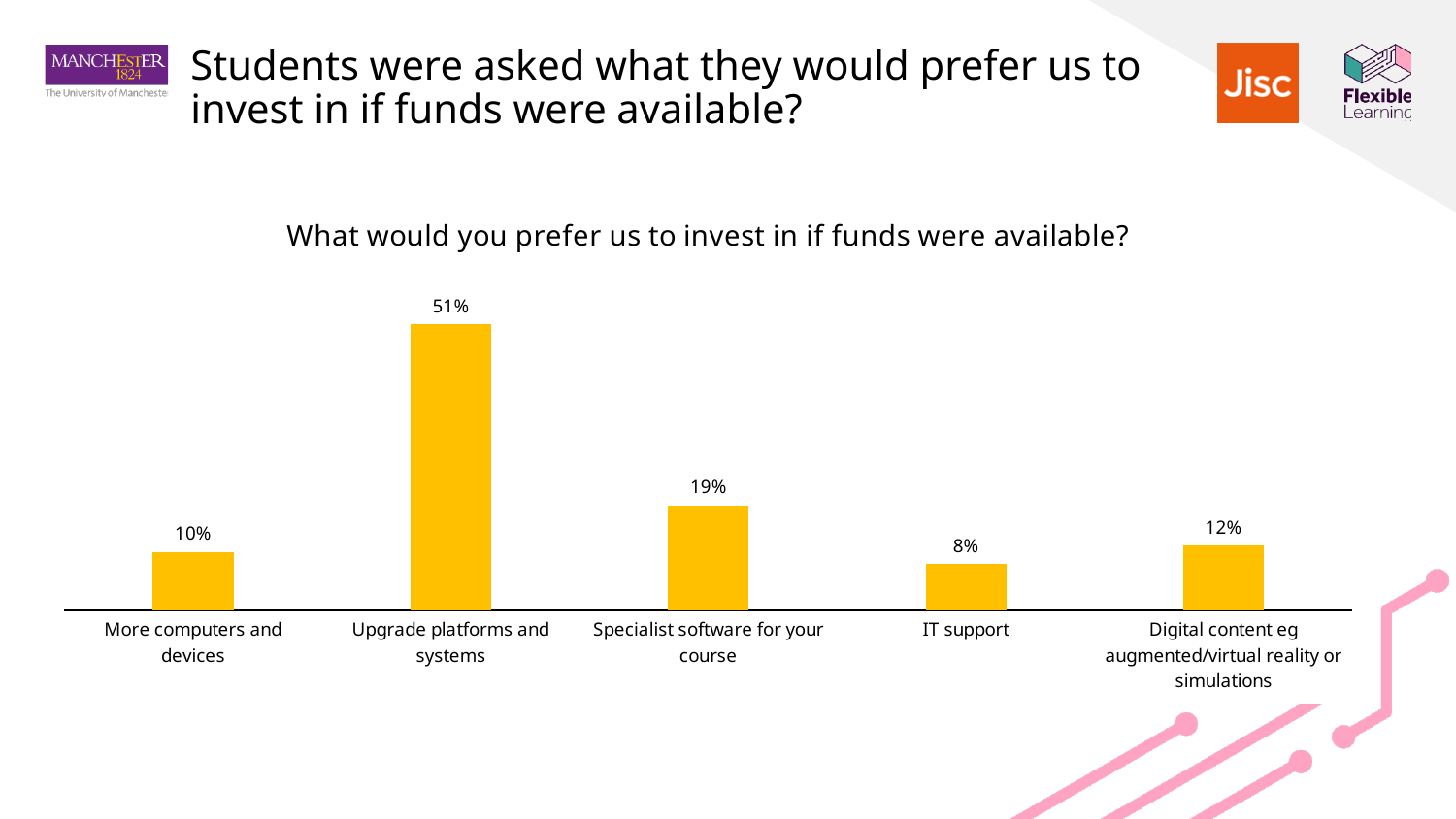
What is the value for 'IT support'? 8% Which is larger: 'More computers and devices' or 'IT support'? More computers and devices What kind of chart is this? Bar chart What is the title of the chart? What would you prefer us to invest in if funds were available? Which category has the lowest value? IT support What is the value for 'Digital content eg augmented/virtual reality or simulations'? 12% Which category has the highest value? Upgrade platforms and systems What percentage of students chose 'Upgrade platforms and systems'? 51% What percentage is shown for 'Specialist software for your course'? 19% What is the difference between 'Digital content eg augmented/virtual reality or simulations' and 'More computers and devices'? 2% What is the difference between 'Upgrade platforms and systems' and 'Specialist software for your course'? 32% How many categories are shown in the chart? 5